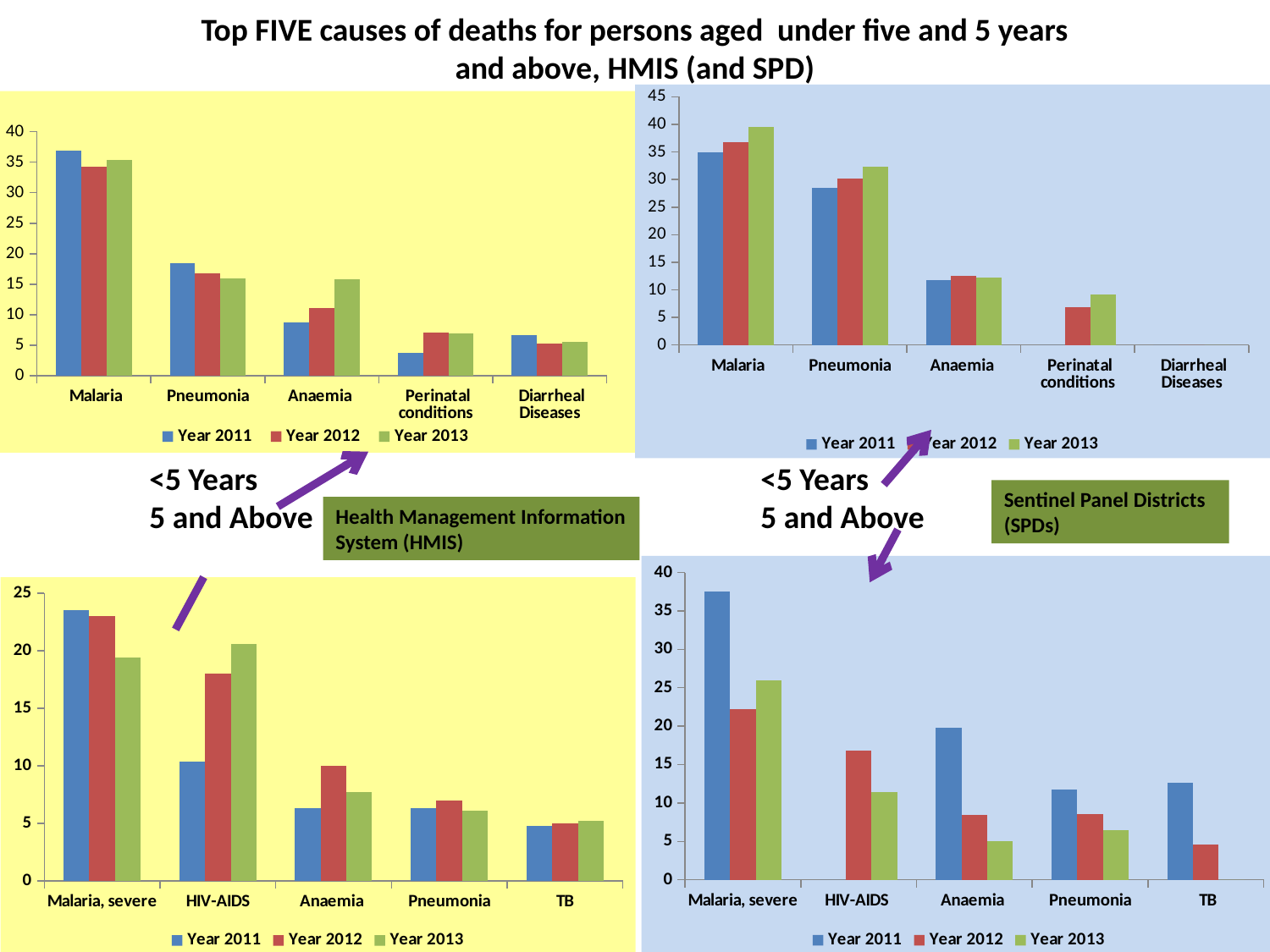
In the bottom-left chart, is the Year 2011 value for Malaria, severe greater or less than 20? greater In the bottom-right chart, which is larger for Malaria, severe: the Year 2011 value or the Year 2012 value? Year 2011 How many series does the legend of the top-left chart list? 3 In the top-left chart, which category has the highest bar? Malaria In the top-right chart, which series has the tallest bar for Malaria? Year 2013 In the top-right chart, is the Year 2011 value for Pneumonia greater or less than 30? less In the top-left chart, is the Year 2011 value for Pneumonia greater or less than 15? greater In the bottom-left chart, which category has the lowest bars overall? TB How many categories are shown on the x axis of the bottom-left chart? 5 What kind of chart is the top-left chart on the slide? bar chart